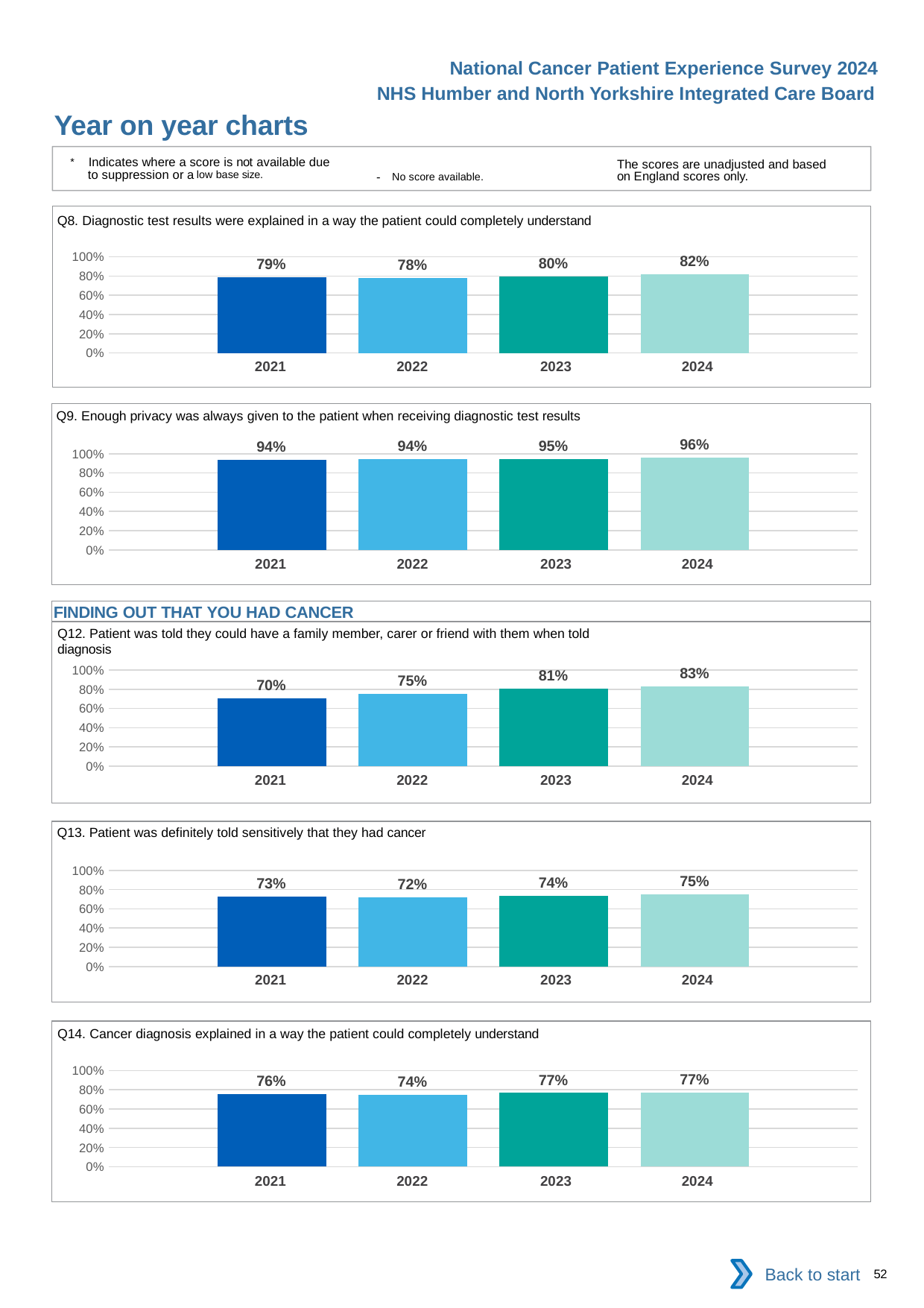
In the Q13 chart, which is larger, the value for 2021 or the value for 2022? 2021 In the Q8 chart, which year has the lowest value? 2022 What kind of chart is the Q8 chart? bar chart In the Q12 chart, do the values rise or fall from 2021 to 2024? rise In the Q8 chart, what is the value for 2024? 82% In the Q14 chart, what is the value for 2022? 74% In the Q9 chart, what is the difference between the 2024 and 2021 values? 2 percentage points In the Q13 chart, what is the value for 2024? 75% In the Q12 chart, what is the difference between the 2021 and 2024 values? 13 percentage points How many years are shown in the Q14 chart? 4 In the Q12 chart, which year has the highest value? 2024 In the Q9 chart, what is the value for 2023? 95%